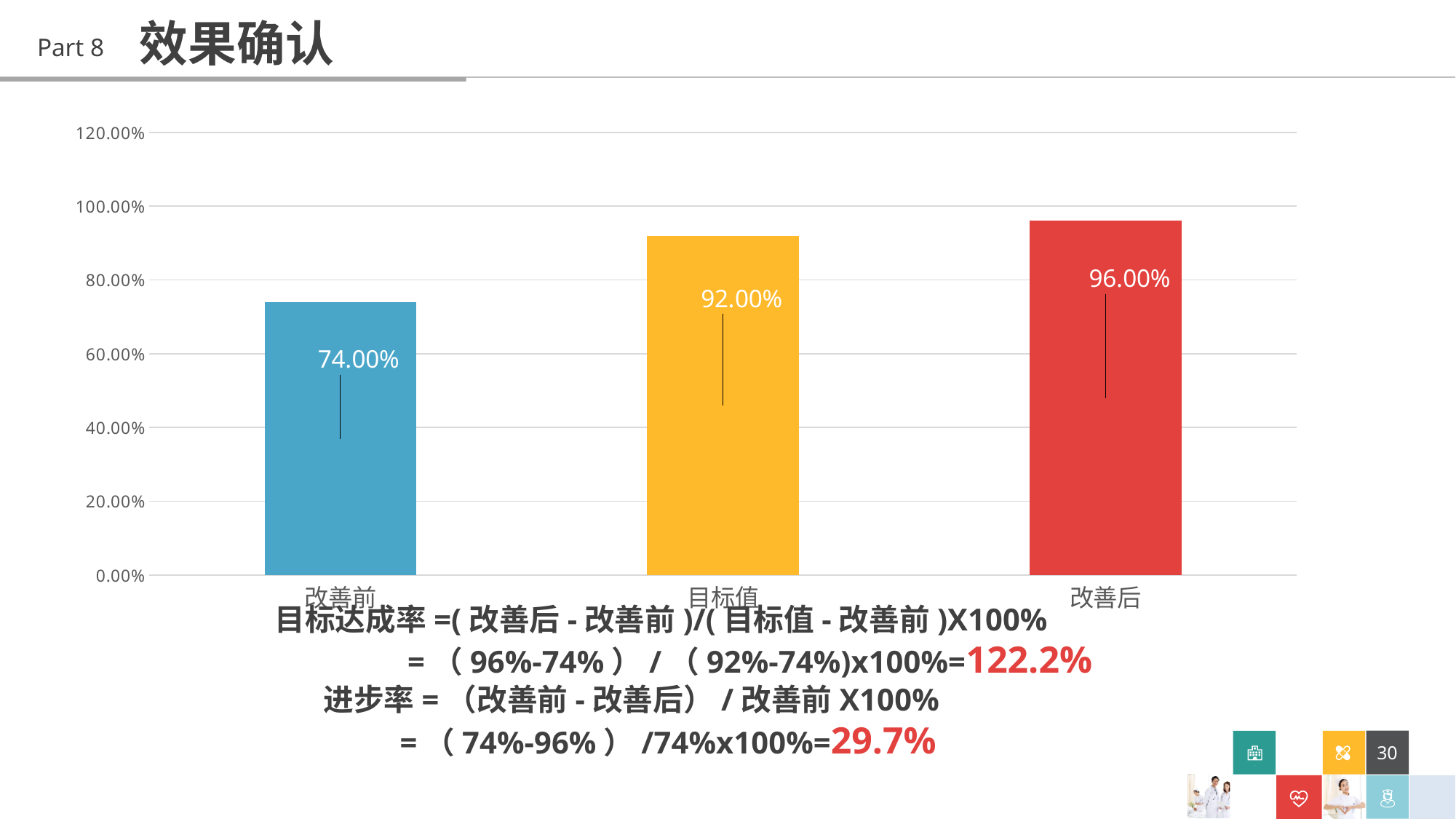
Which is larger, the value for 改善后 or the value for 目标值? 改善后 Which category has the lowest value? 改善前 What is the difference between the values for 改善后 and 改善前? 22.00% How many categories are shown in the chart? 3 What colour is the bar for 目标值? yellow Is the value for 改善前 greater or less than 80.00%? less What kind of chart is shown on the slide? bar chart What is the value for 目标值? 92.00% What is the difference between the values for 目标值 and 改善前? 18.00% Which category has the highest value? 改善后 What is the value for 改善前? 74.00% What is the value for 改善后? 96.00%